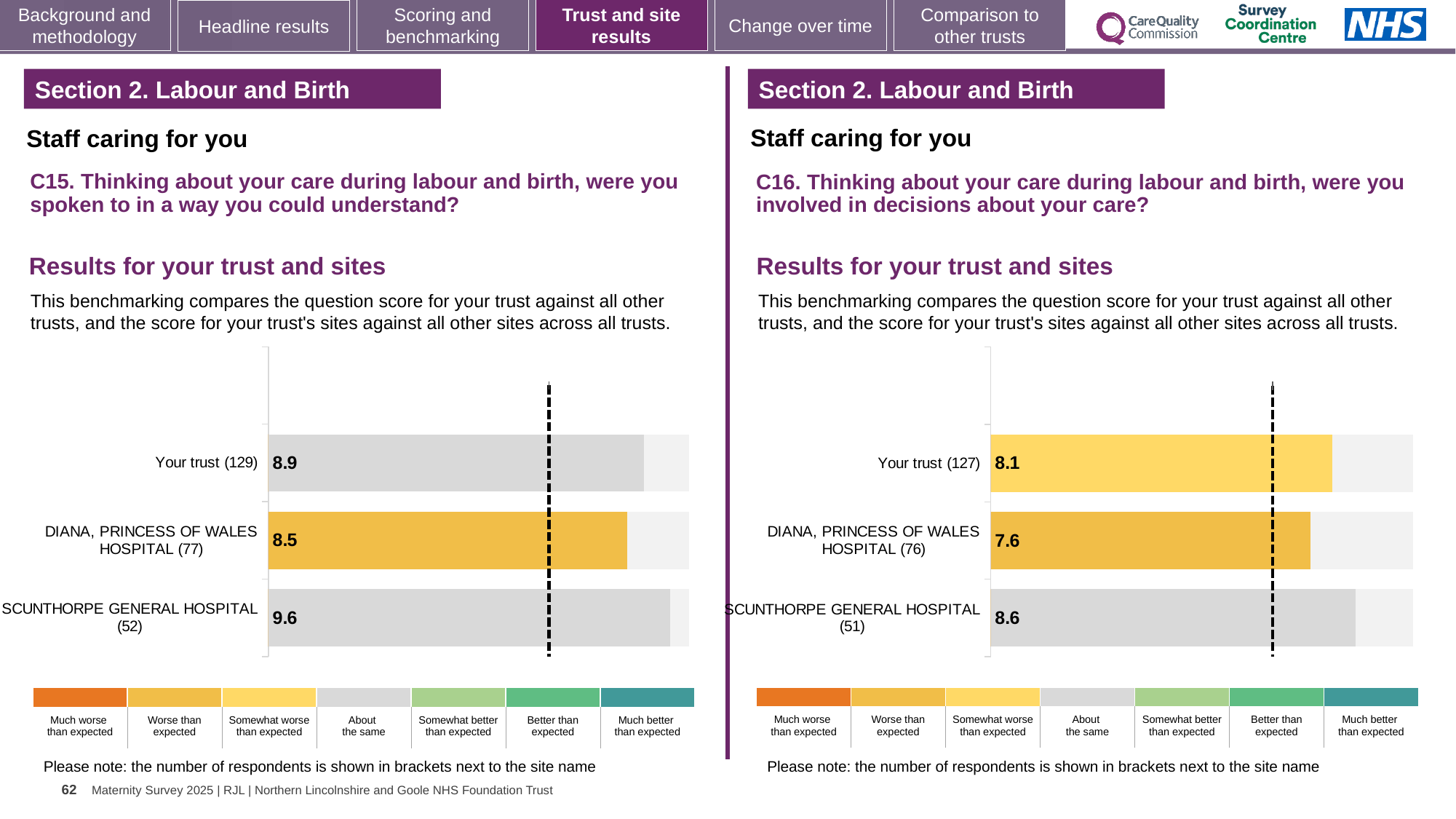
On the C16 chart (right), what is the score for Your trust (127)? 8.1 On the C16 chart (right), which has the larger score: Your trust (127) or SCUNTHORPE GENERAL HOSPITAL (51)? SCUNTHORPE GENERAL HOSPITAL (51) On the C15 chart (left), what is the score for DIANA, PRINCESS OF WALES HOSPITAL (77)? 8.5 On the C15 chart (left), what is the difference between the scores for SCUNTHORPE GENERAL HOSPITAL (52) and DIANA, PRINCESS OF WALES HOSPITAL (77)? 1.1 On the C16 chart (right), which site or trust has the lowest score? DIANA, PRINCESS OF WALES HOSPITAL (76) On the C15 chart (left), which site or trust has the highest score? SCUNTHORPE GENERAL HOSPITAL (52) On the C15 chart (left), what is the score for Your trust (129)? 8.9 On the C16 chart (right), what is the score for SCUNTHORPE GENERAL HOSPITAL (51)? 8.6 How many bars are plotted on the C15 chart (left)? 3 On the C16 chart (right), which benchmark category does the colour of the Your trust (127) bar correspond to in the legend? Somewhat worse than expected On the C16 chart (right), what is the difference between the scores for Your trust (127) and DIANA, PRINCESS OF WALES HOSPITAL (76)? 0.5 What kind of chart is used on the C16 chart (right)? Bar chart